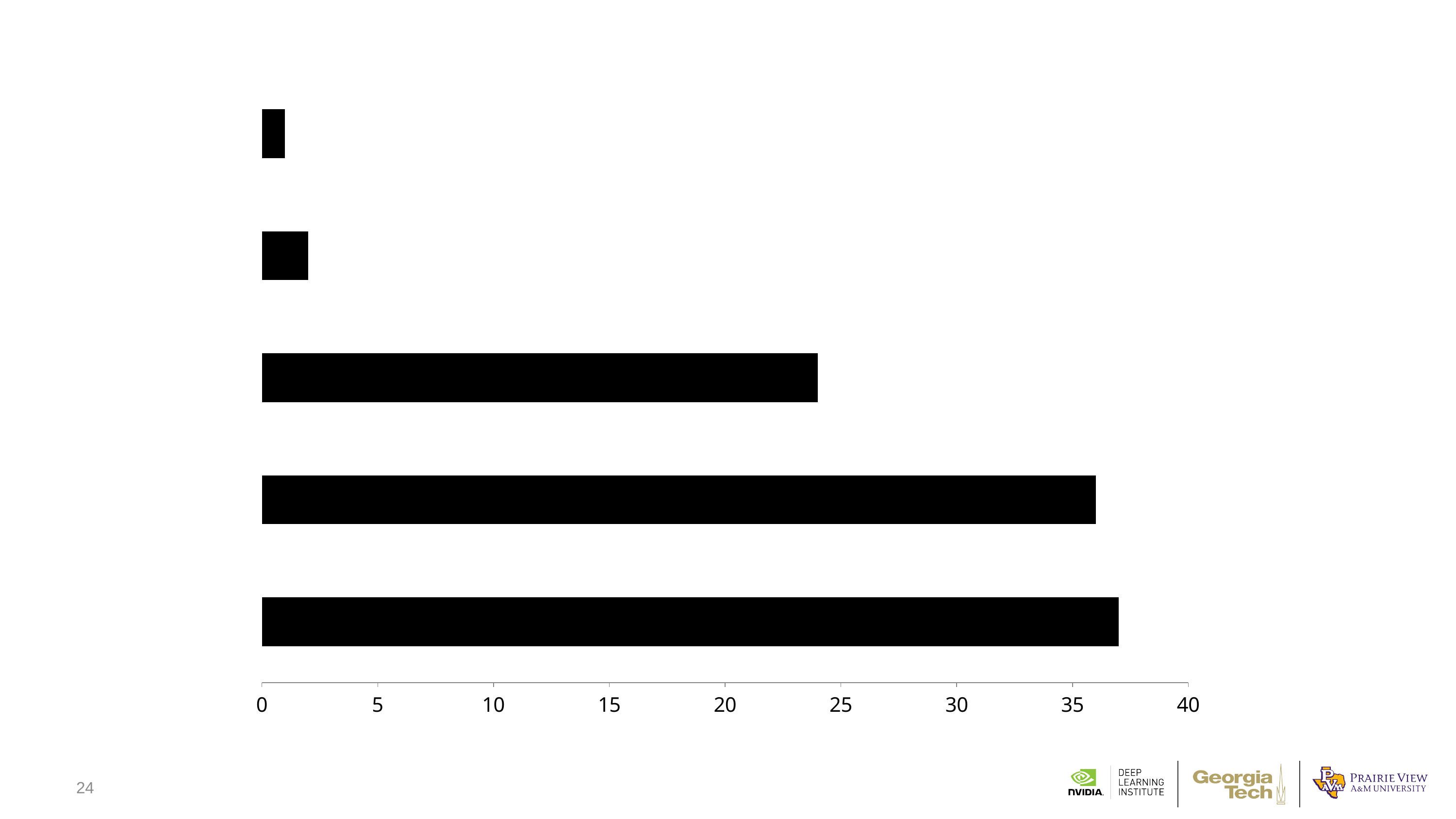
Is the value of the top bar greater or less than 5? less What kind of chart is shown on the slide? bar chart Do the bars get longer or shorter going from the top of the chart to the bottom? longer What is the highest value shown on the horizontal axis? 40 Is the value of the middle (third) bar greater or less than 20? greater Which bar is the longest: the top bar or the bottom bar? the bottom bar Is the value of the middle (third) bar greater or less than 25? less Is the middle (third) bar longer or shorter than the bottom bar? shorter Which bar is the shortest in the chart? the top bar How many bars does the chart show? 5